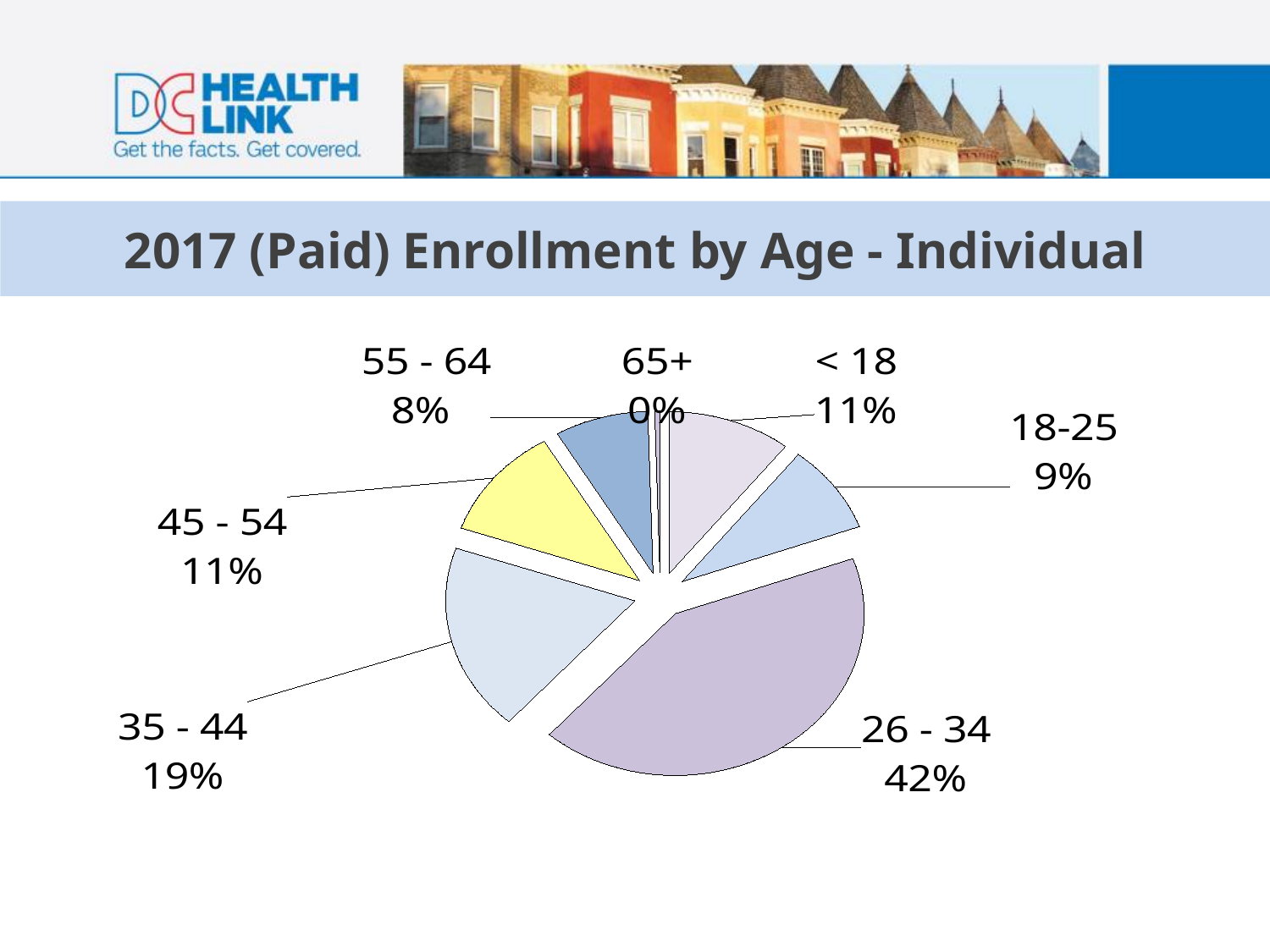
What share of enrollment is the 18-25 age group? 9% What share of enrollment is the 35 - 44 age group? 19% What share of enrollment is the 26 - 34 age group? 42% Which age group has the smallest share of enrollment? 65+ Which age group has the largest share of enrollment? 26 - 34 Which has a larger share, the 55 - 64 age group or the 45 - 54 age group? 45 - 54 What share of enrollment is the < 18 age group? 11% What kind of chart is shown on the slide? Pie chart What share of enrollment is the 65+ age group? 0% What is the difference in percentage points between the 26 - 34 and 35 - 44 age groups? 23 How many age groups are shown in the pie chart? 7 What is the title of the chart? 2017 (Paid) Enrollment by Age - Individual